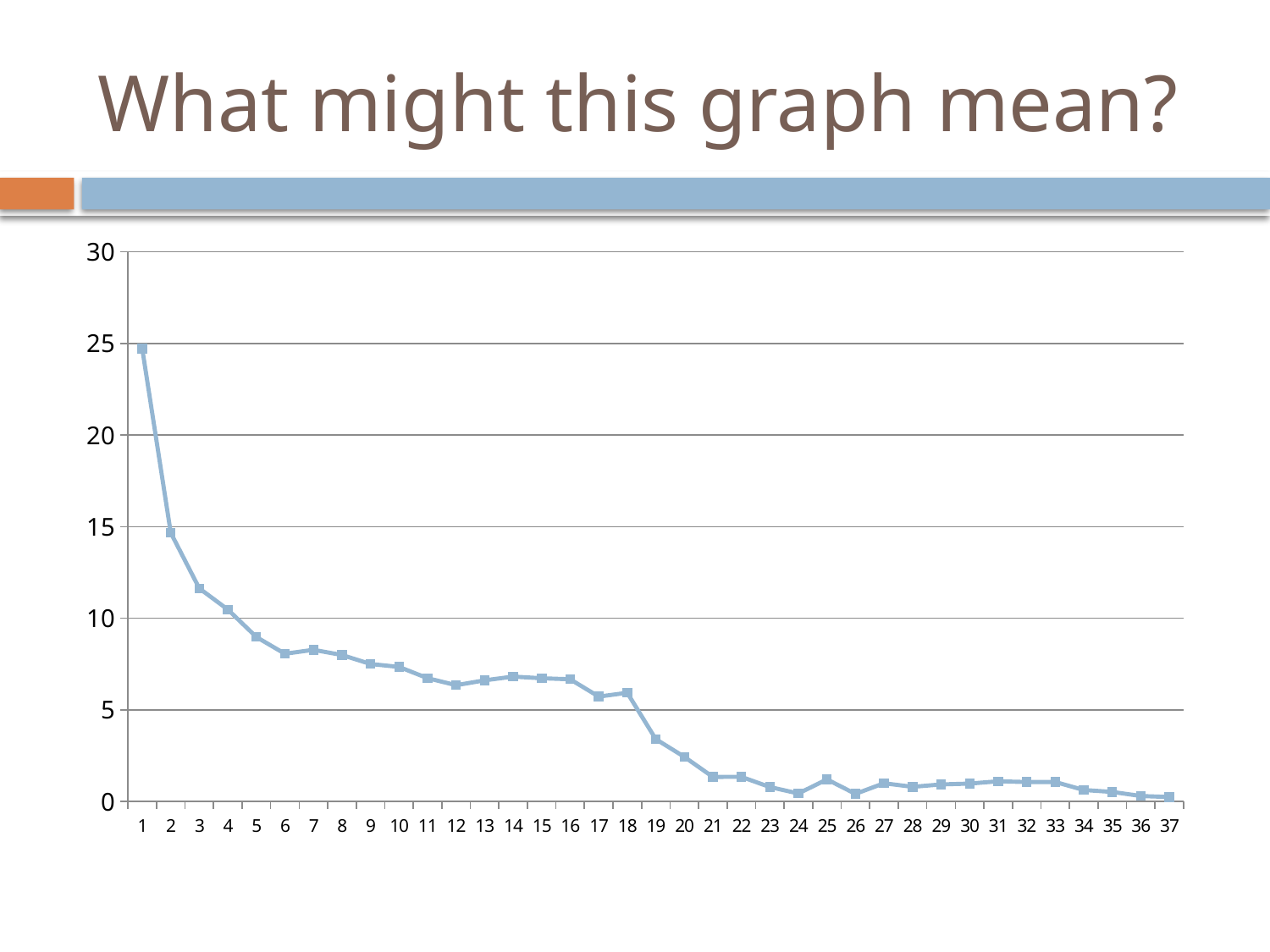
Is the value at point 3 greater or less than 10? greater Is the value at point 6 greater or less than 10? less Is the value at point 12 greater or less than 5? greater What is the highest value shown on the y axis? 30 Do the values generally rise or fall as the x axis goes from 1 to 37? fall Which has the larger value, point 18 or point 19? point 18 How many points are plotted along the x axis? 37 Which x-axis point has the highest value? 1 Which has the larger value, point 1 or point 2? point 1 What kind of chart is shown on the slide? line chart